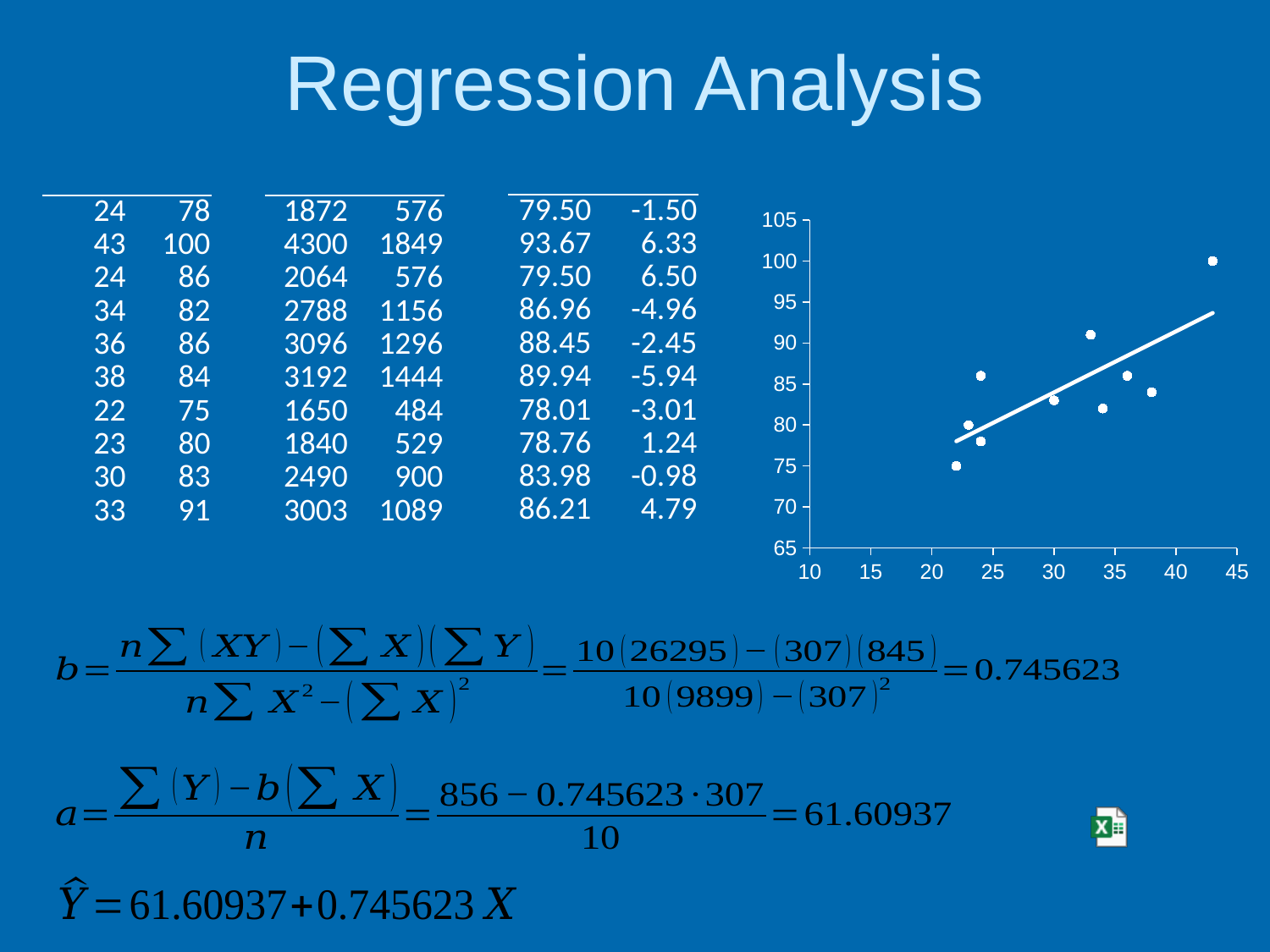
Do the plotted values generally rise or fall as the x value increases? rise Is the y value of the point near x = 34 greater or less than 85? less How many data points are plotted in the scatter chart? 10 How many plotted points have a y value above 90? 2 What kind of chart is shown on the slide? scatter chart Is the y value of the leftmost point (near x = 22) greater or less than 80? less Is the y value of the point near x = 30 greater or less than 80? greater What is the range of the x axis in the scatter chart? 10 to 45 What is the y value of the highest plotted point in the scatter chart? 100 What is the y value of the lowest plotted point in the scatter chart? 75 What is the range of the y axis in the scatter chart? 65 to 105